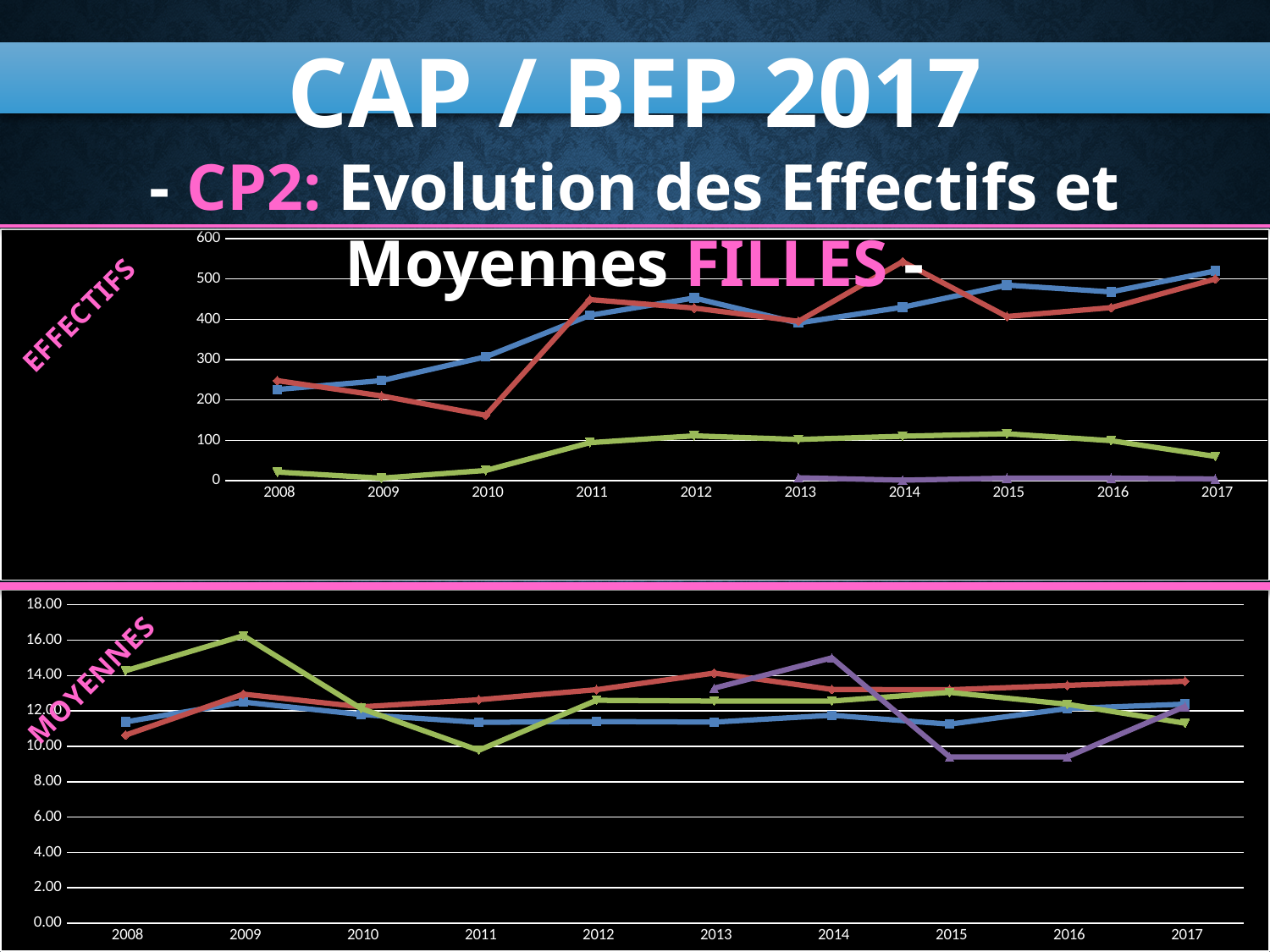
What is the highest value shown on the y axis of the top chart (EFFECTIFS)? 600 In the top chart (EFFECTIFS), how many years are shown on the x axis? 10 In the bottom chart (MOYENNES), is the value of the purple line in 2015 greater or less than 10.00? less In the bottom chart (MOYENNES), in which year does the green line reach its highest value? 2009 In the bottom chart (MOYENNES), in which year is the green line at its lowest? 2011 In the top chart (EFFECTIFS), in which year is the green line at its lowest? 2009 In the top chart (EFFECTIFS), is the value of the blue line in 2008 greater or less than 300? less In the top chart (EFFECTIFS), is the value of the red line in 2010 greater or less than 200? less What kind of chart is the top chart labelled EFFECTIFS? line chart In the top chart (EFFECTIFS), in which year does the red line reach its highest value? 2014 In the top chart (EFFECTIFS), which line is higher in 2015, the blue line or the red line? the blue line In the top chart (EFFECTIFS), does the blue line overall rise or fall from 2008 to 2017? rise